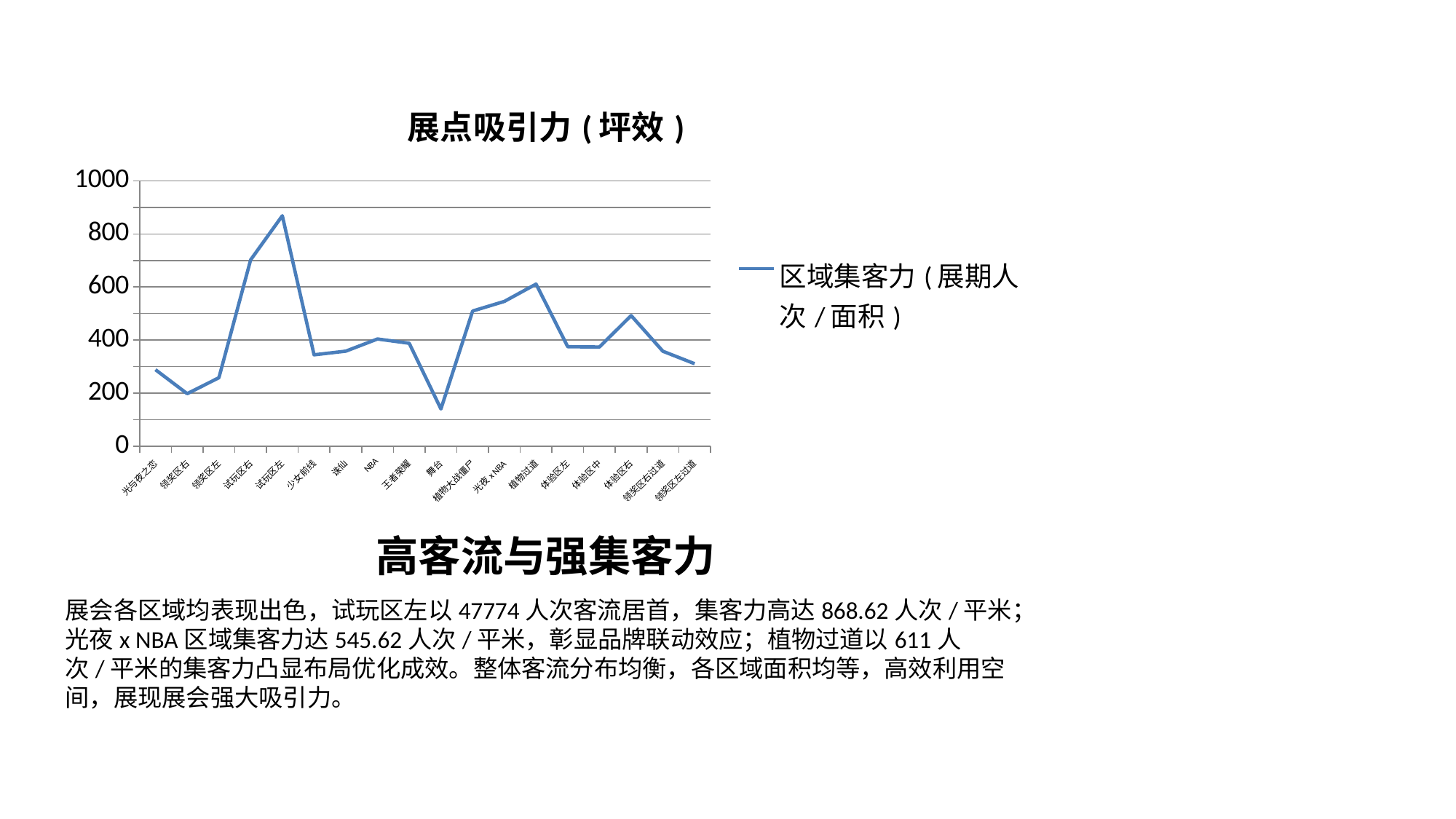
Is the value for 试玩区右 greater or less than 600? greater Do the values rise or fall from 领奖区右 to 试玩区左? rise What kind of chart is shown on the slide? line chart What is the title of the chart? 展点吸引力（坪效） Which is larger, the value for 试玩区右 or the value for 植物过道? 试玩区右 Is the value for 少女前线 greater or less than 400? less What is the name of the series shown in the legend? 区域集客力（展期人次/面积） Is the value for 舞台 greater or less than 200? less Which category has the lowest value? 舞台 Which category has the highest value? 试玩区左 How many series does the legend list? 1 How many categories are plotted along the x axis? 18